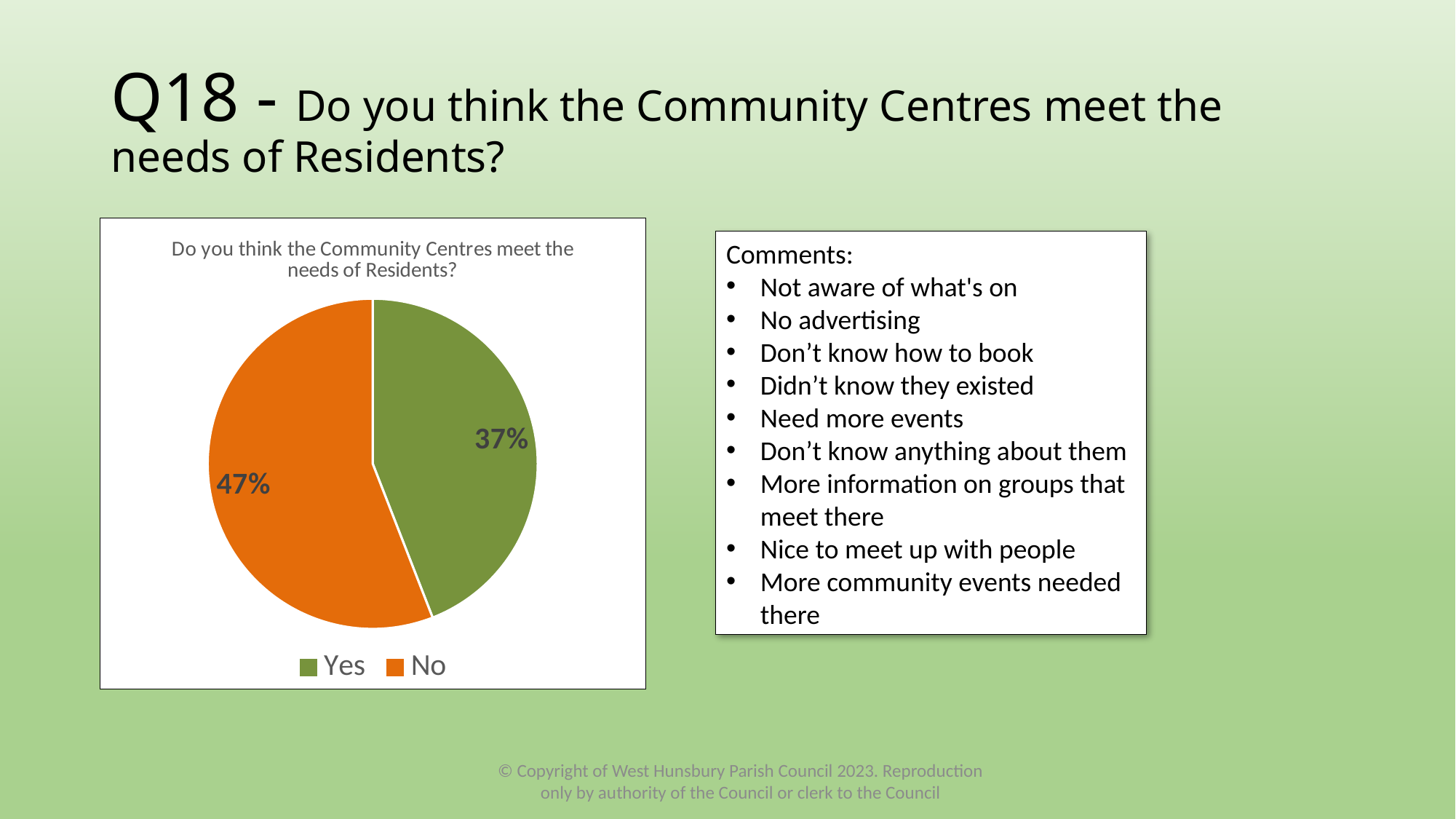
What is the title of the pie chart? Do you think the Community Centres meet the needs of Residents? How many entries does the legend list? 2 What is the difference in percentage points between the No and Yes slices? 10 What colour is the Yes slice in the pie chart? Green How many slices does the pie chart have? 2 What percentage of respondents answered No? 47% Which response has the larger share of the pie? No What kind of chart is shown on the slide? Pie chart Which response has the smaller share of the pie? Yes Is the share for Yes larger or smaller than the share for No? Smaller What percentage of respondents answered Yes? 37%